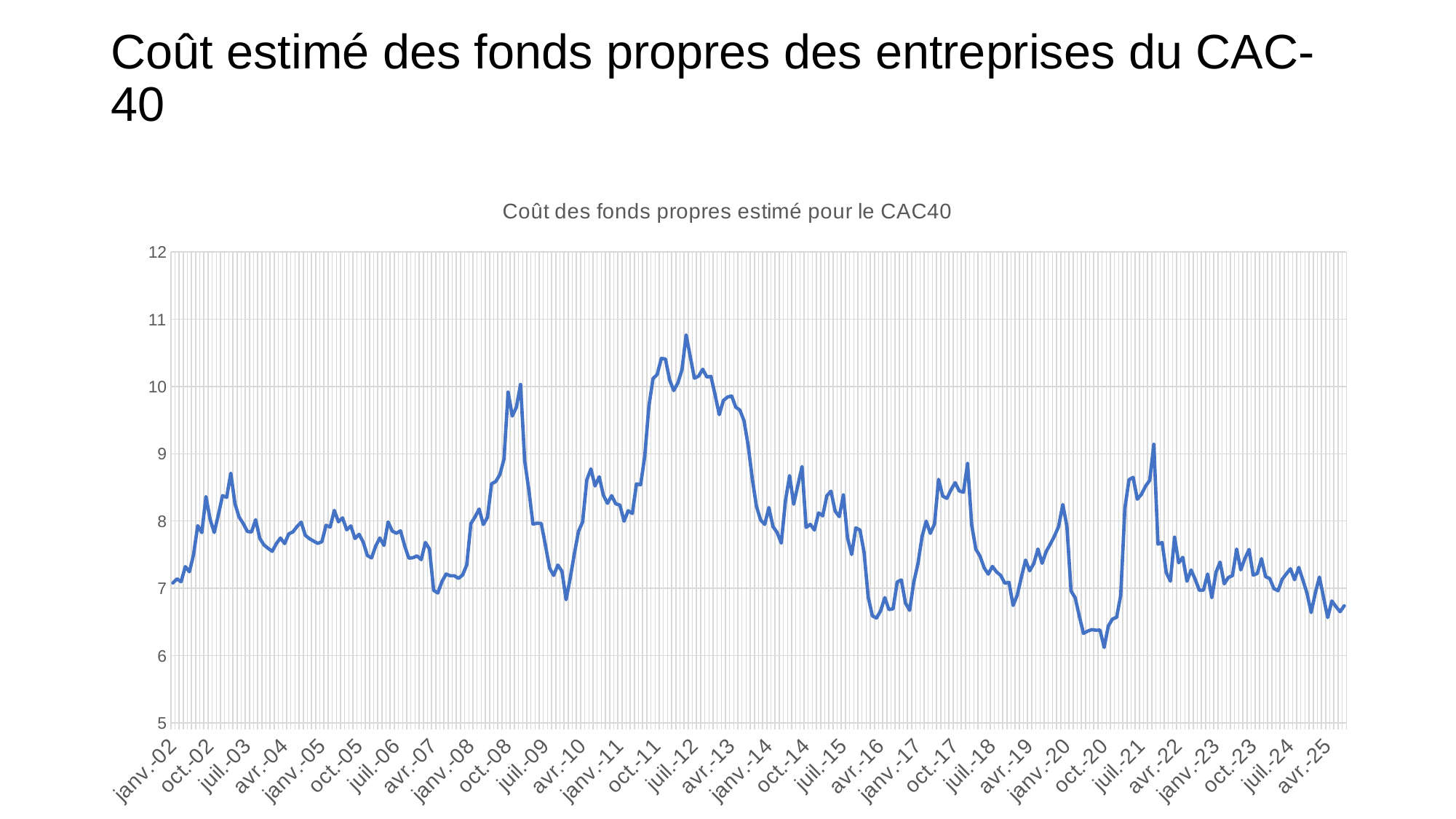
Around which x-axis label does the line reach its highest value? juil.-12 Which is larger, the value around juil.-12 or the value around oct.-20? juil.-12 Is the value around juil.-12 greater or less than 10? greater Is the value around oct.-20 greater or less than 7? less What is the title printed above the chart? Coût des fonds propres estimé pour le CAC40 What are the lowest and highest values shown on the vertical axis? 5 and 12 Around which x-axis label does the line reach its lowest value? oct.-20 Between juil.-12 and avr.-16, do the values generally rise or fall? fall How many data series are plotted on the chart? 1 What kind of chart is shown on the slide? line chart Is the value around avr.-16 greater or less than 7? less